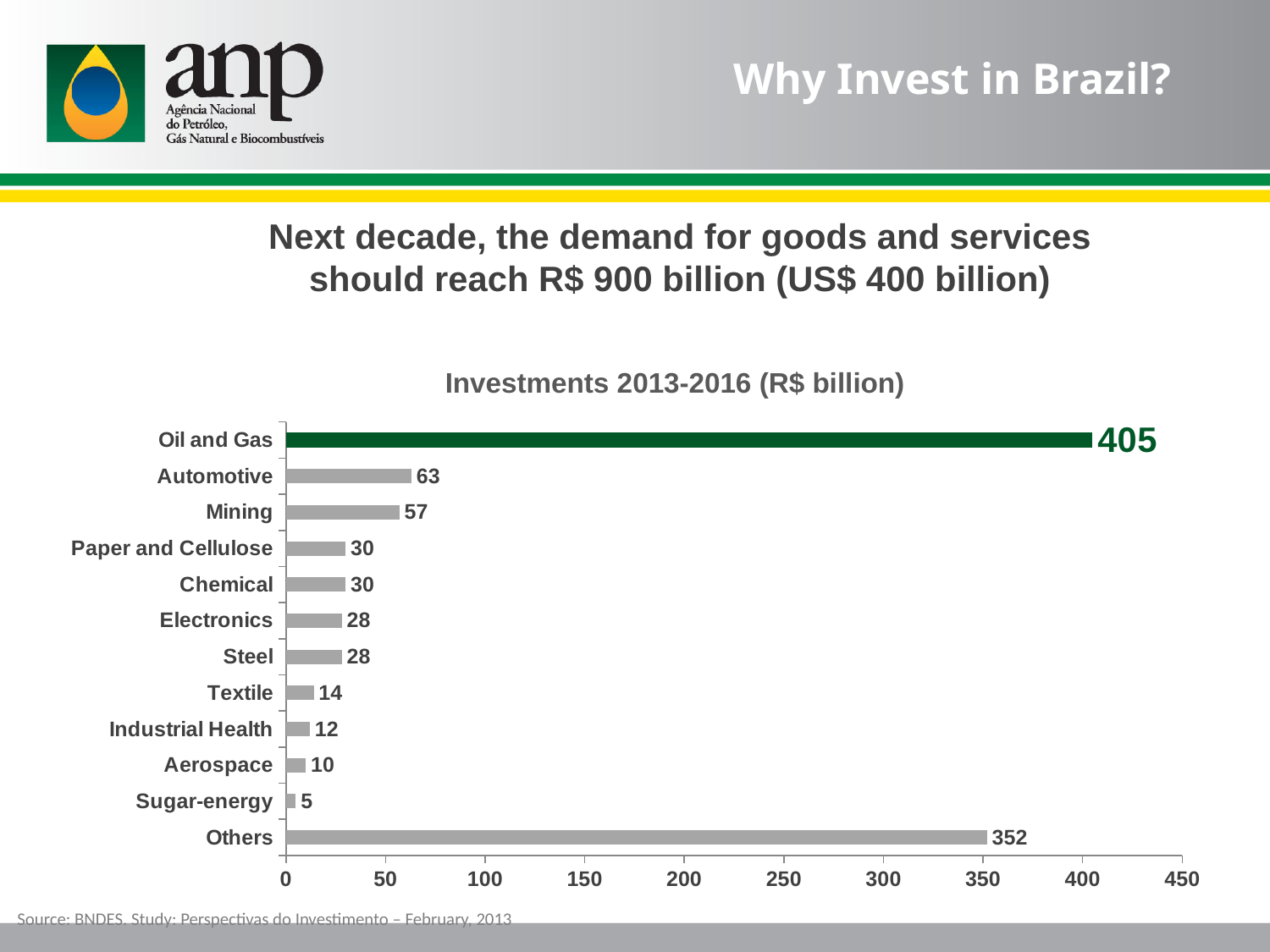
Which is larger, the value for Textile or the value for Industrial Health? Textile What is the difference between the values for Oil and Gas and Others? 53 What kind of chart is shown on the slide? Bar chart Which category has the lowest investment value? Sugar-energy What is the value for Mining? 57 What is the difference between the values for Automotive and Mining? 6 What is the value for Others? 352 Is the value for Others greater or less than 300? greater What is the value for Oil and Gas in the Investments 2013-2016 chart? 405 Which category has the highest investment value? Oil and Gas How many categories are shown in the chart? 12 What is the title of the chart? Investments 2013-2016 (R$ billion)